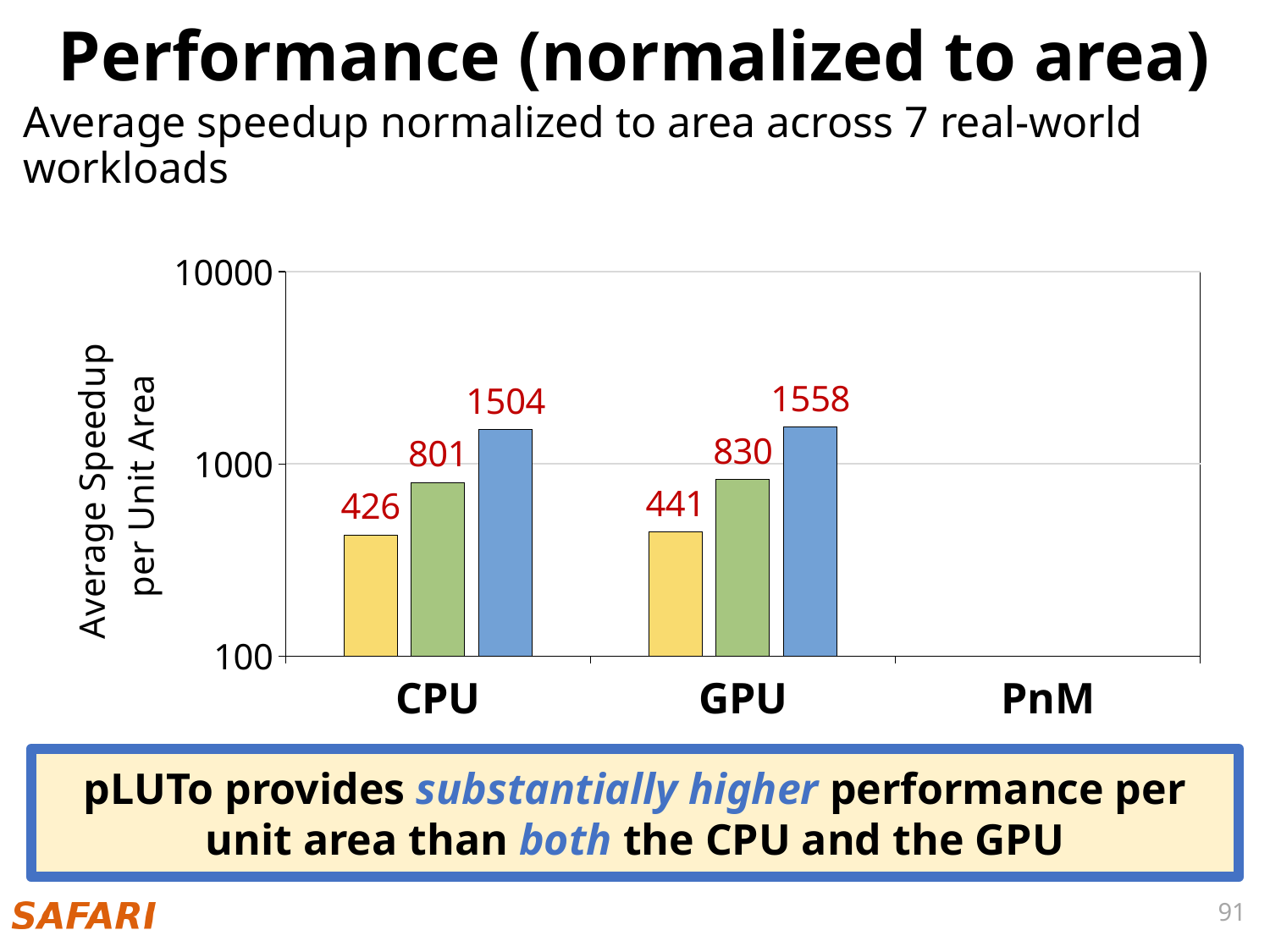
What is the value of the blue bar for GPU? 1558 What is the value of the green bar for GPU? 830 Which is larger, the green bar for CPU or the green bar for GPU? The green bar for GPU Is the value of the yellow bar for GPU greater or less than 1000? less What is the value of the yellow bar for CPU? 426 What is the difference between the blue bar for GPU and the blue bar for CPU? 54 What kind of chart is shown on the slide? Bar chart Which bar has the lowest labeled value on the chart? The yellow bar for CPU (426) What is the value of the blue bar for CPU? 1504 How many categories are shown on the x axis? 3 What is the difference between the green bar and the yellow bar for CPU? 375 Which category has the highest labeled bar value? GPU